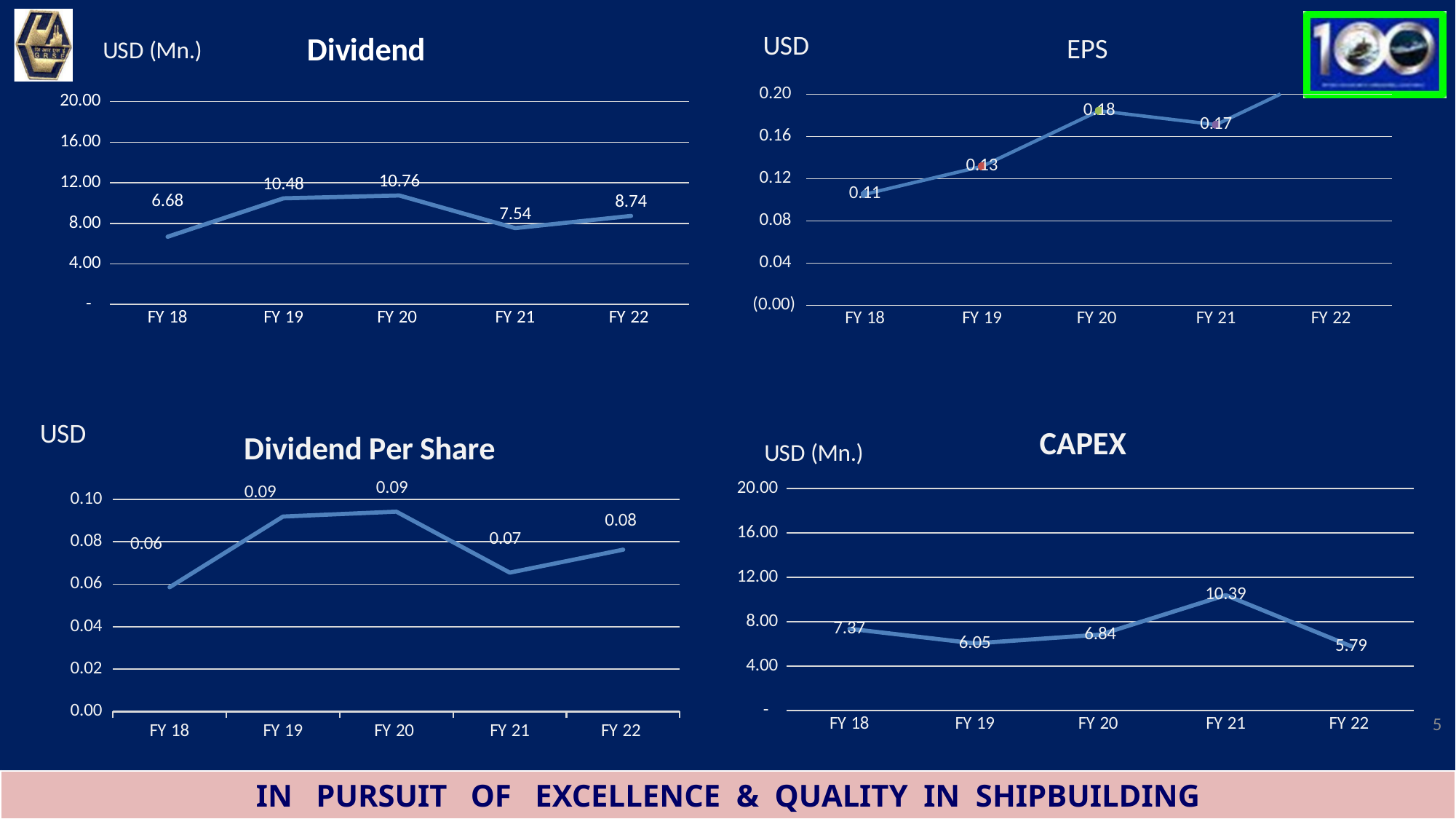
In the CAPEX chart, which fiscal year has the highest value? FY 21 In the EPS chart, which is larger, the value for FY 20 or the value for FY 21? FY 20 In the Dividend chart, what is the difference between the FY 20 and FY 21 values? 3.22 In the Dividend Per Share chart, how many fiscal years are plotted? 5 In the CAPEX chart, what is the difference between the FY 21 and FY 22 values? 4.60 In the Dividend Per Share chart, what is the value for FY 22? 0.08 In the EPS chart, what is the value for FY 19? 0.13 In the Dividend chart, which fiscal year has the lowest value? FY 18 In the CAPEX chart, what is the value for FY 19? 6.05 What kind of chart is the CAPEX chart? Line chart In the Dividend chart, what is the value for FY 20? 10.76 In the CAPEX chart, is the value for FY 21 greater or less than 8.00? greater